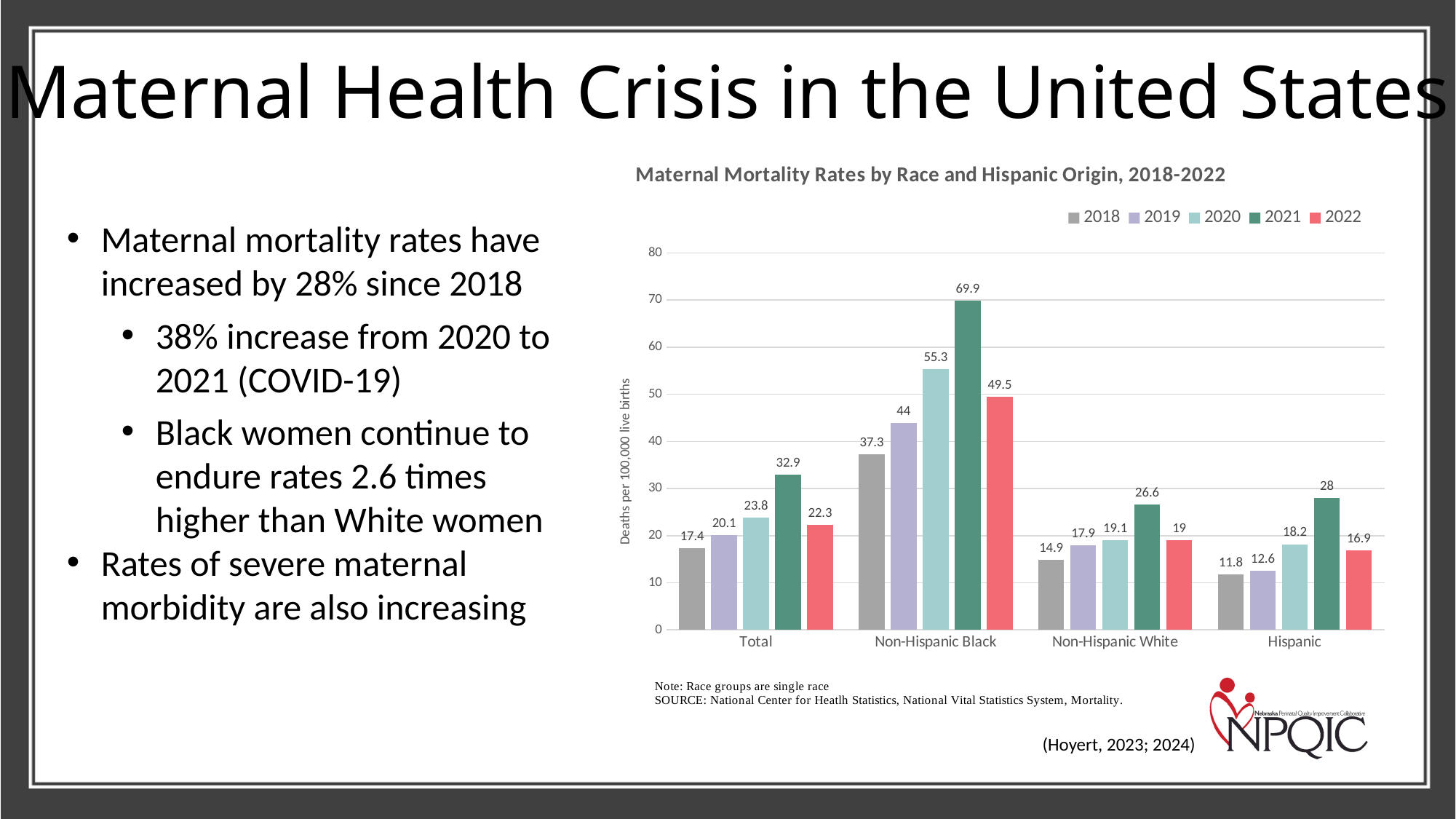
Which race/origin group had the lowest maternal mortality rate in 2018? Hispanic What was the Total maternal mortality rate in 2018? 17.4 How many years does the legend list? 5 What kind of chart is shown on the slide? Bar chart What was the maternal mortality rate for Non-Hispanic Black women in 2021? 69.9 What is the title of the chart? Maternal Mortality Rates by Race and Hispanic Origin, 2018-2022 Which race/origin group had the highest maternal mortality rate in 2021? Non-Hispanic Black For the Total group, did the maternal mortality rate rise or fall from 2018 to 2021? Rise What was the maternal mortality rate for Hispanic women in 2022? 16.9 What is the difference between the Non-Hispanic Black rate in 2021 and in 2022? 20.4 How many race/origin groups are shown on the x axis? 4 Which was higher in 2020: the Non-Hispanic White rate or the Hispanic rate? Non-Hispanic White